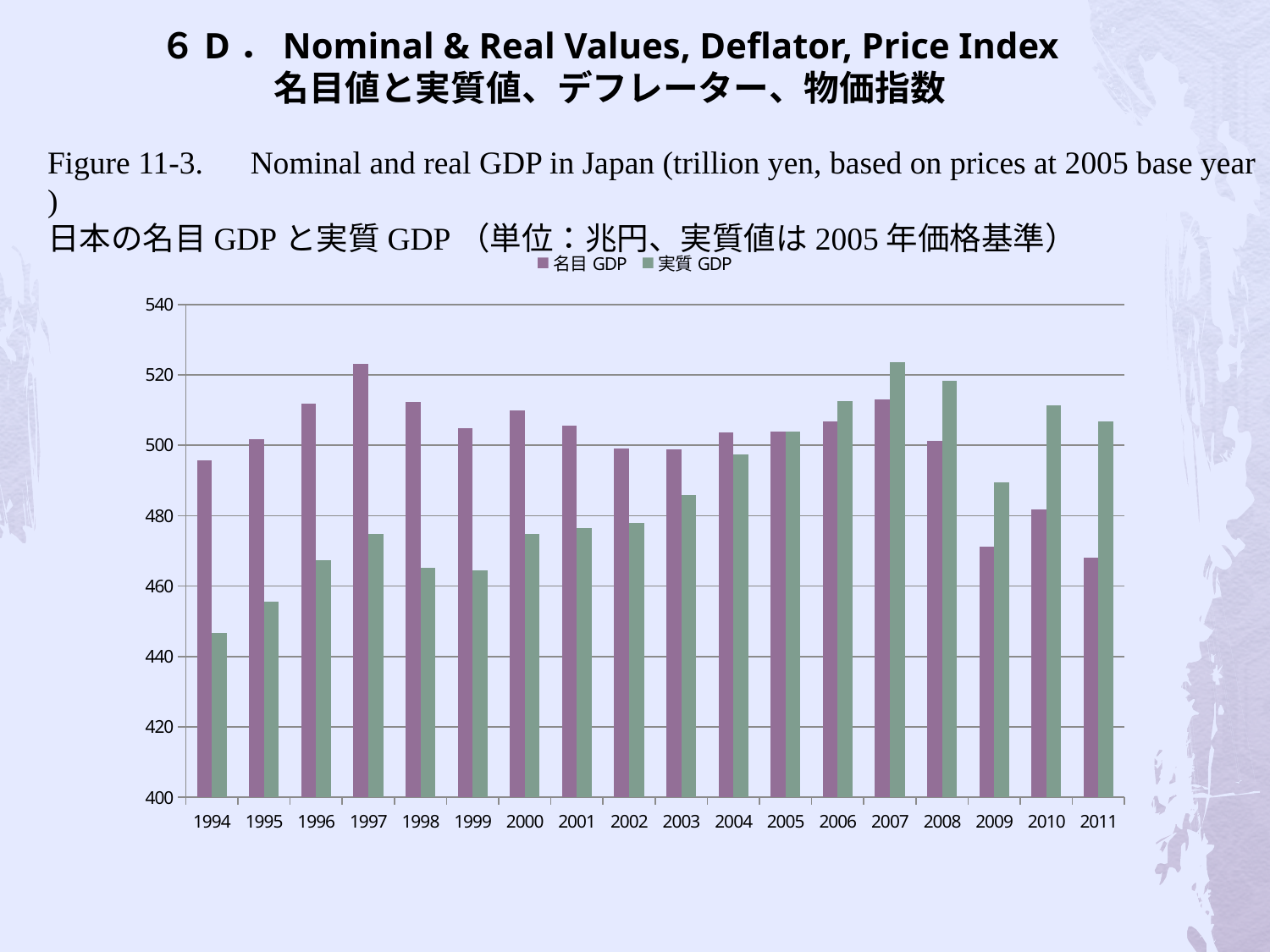
How many years are shown on the x axis of the chart? 18 In 2011, which is larger, 名目 GDP or 実質 GDP? 実質 GDP How many series does the chart's legend list? 2 Does 実質 GDP generally rise or fall from 1994 to 2007? rise Which year has the lowest 実質 GDP (real GDP) bar? 1994 Is the 名目 GDP value for 1997 greater or less than 520? greater Which year has the highest 実質 GDP (real GDP) bar? 2007 What kind of chart is shown on the slide? Bar chart In 1994, which is larger, 名目 GDP or 実質 GDP? 名目 GDP Which year has the highest 名目 GDP (nominal GDP) bar? 1997 Is the 実質 GDP value for 1994 greater or less than 460? less Is the 名目 GDP value for 2009 greater or less than 480? less